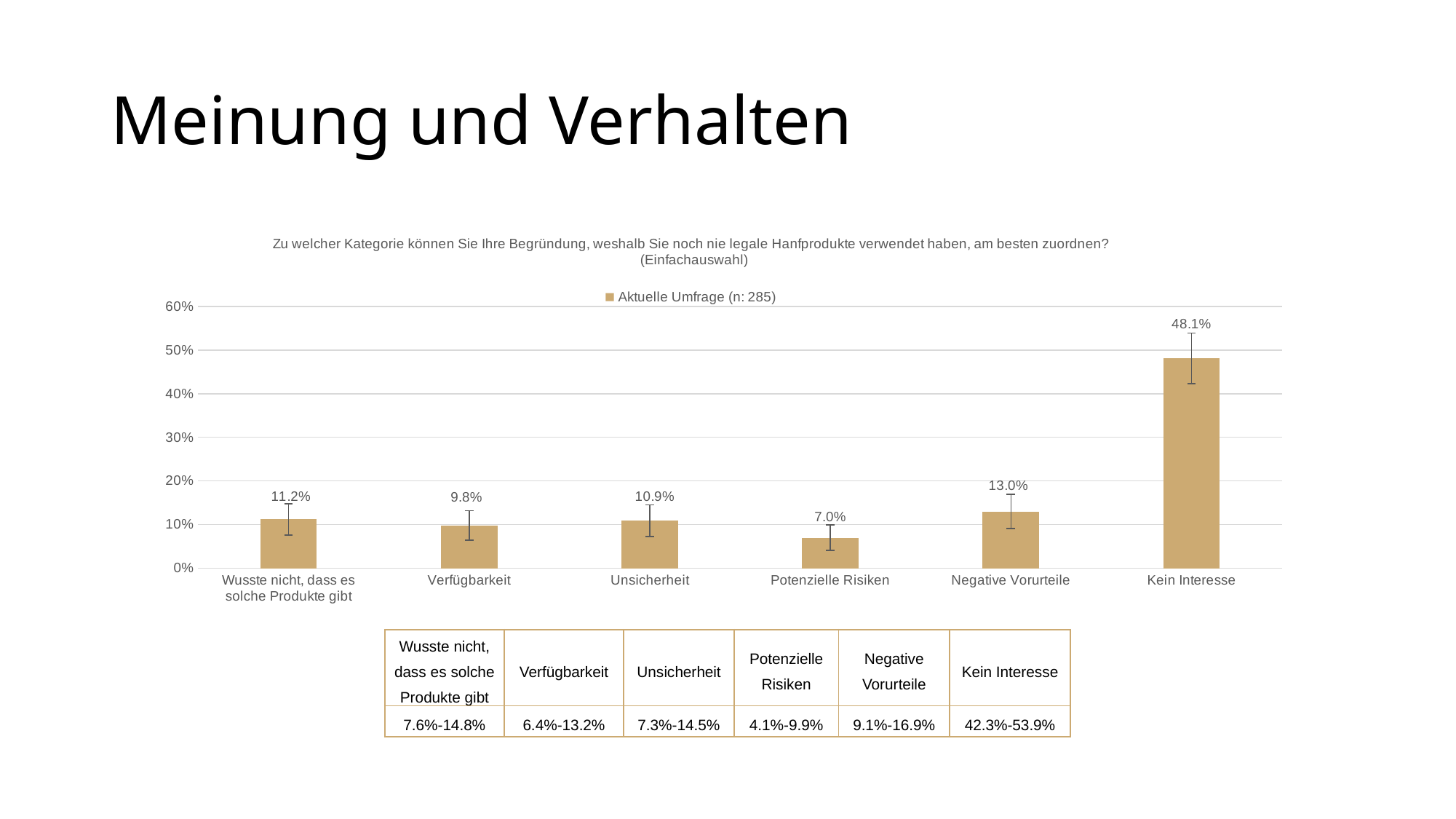
Which category has the lowest value? Potenzielle Risiken Is the value for Unsicherheit greater or less than 20%? less What is the value for Negative Vorurteile? 13.0% Which is larger, the value for Wusste nicht, dass es solche Produkte gibt or the value for Verfügbarkeit? Wusste nicht, dass es solche Produkte gibt Which category has the highest value? Kein Interesse What series does the legend list? Aktuelle Umfrage (n: 285) What is the value for Potenzielle Risiken? 7.0% What kind of chart is shown? bar chart What is the value for Verfügbarkeit? 9.8% What is the difference between the values for Kein Interesse and Negative Vorurteile? 35.1% What is the value for Kein Interesse? 48.1% How many categories are shown on the x axis? 6